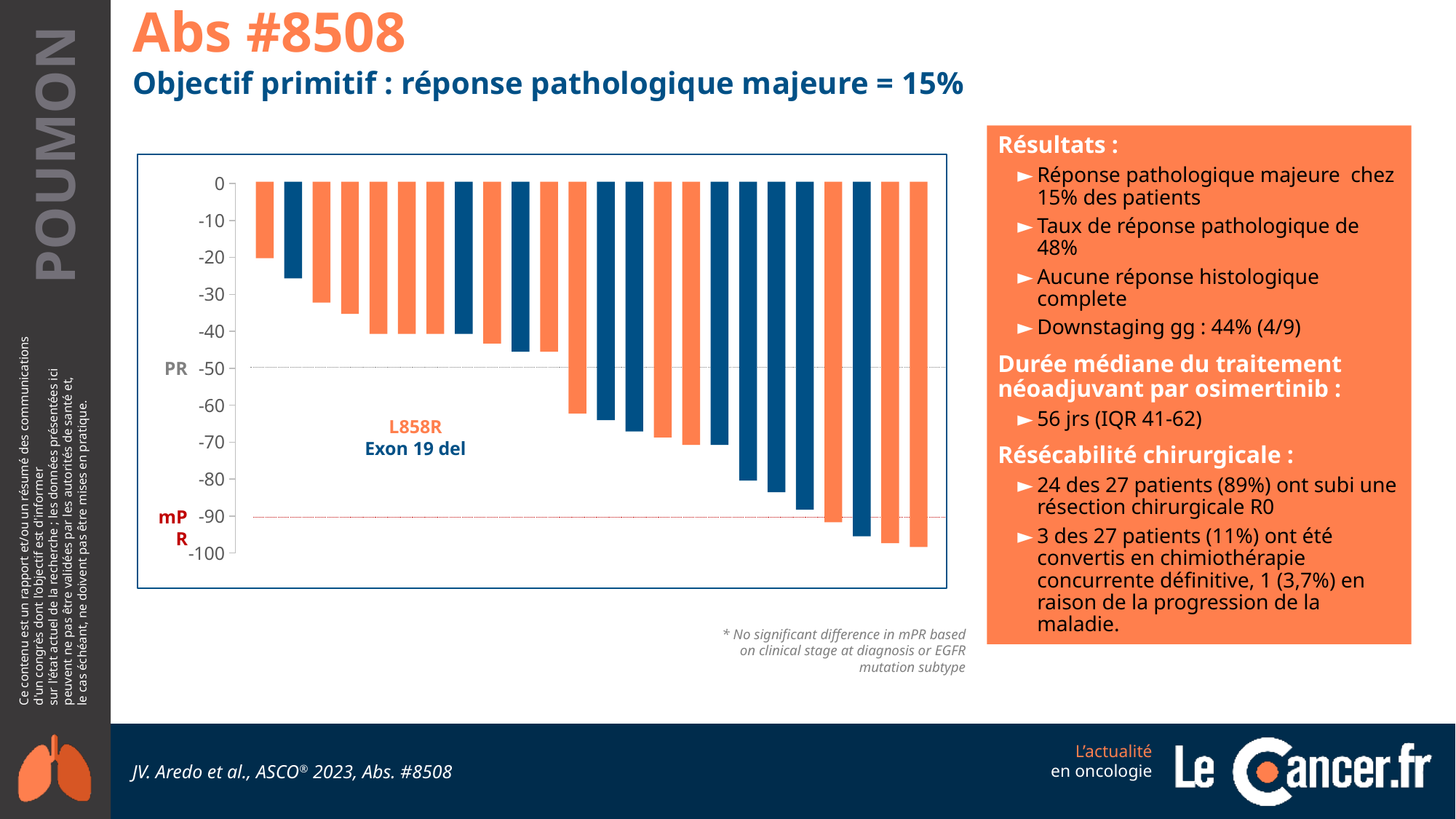
What is the highest tick label shown on the y axis? 0 At what y-axis value is the dotted PR reference line drawn? -50 Is the value of the leftmost bar greater or less than -30? greater Which bar has the lowest value, the leftmost bar or the rightmost bar? the rightmost bar Do the bar values rise or fall from left to right along the x axis? fall Which colour represents the L858R mutation subtype in the chart? orange Which mutation subtype is shown by the dark blue bars? Exon 19 del What kind of chart is shown on the slide? bar chart Is the value of the rightmost bar greater or less than -90? less At what y-axis value is the red dotted mPR reference line drawn? -90 Is the value of the second bar from the left greater or less than -30? greater What is the lowest tick label shown on the y axis? -100